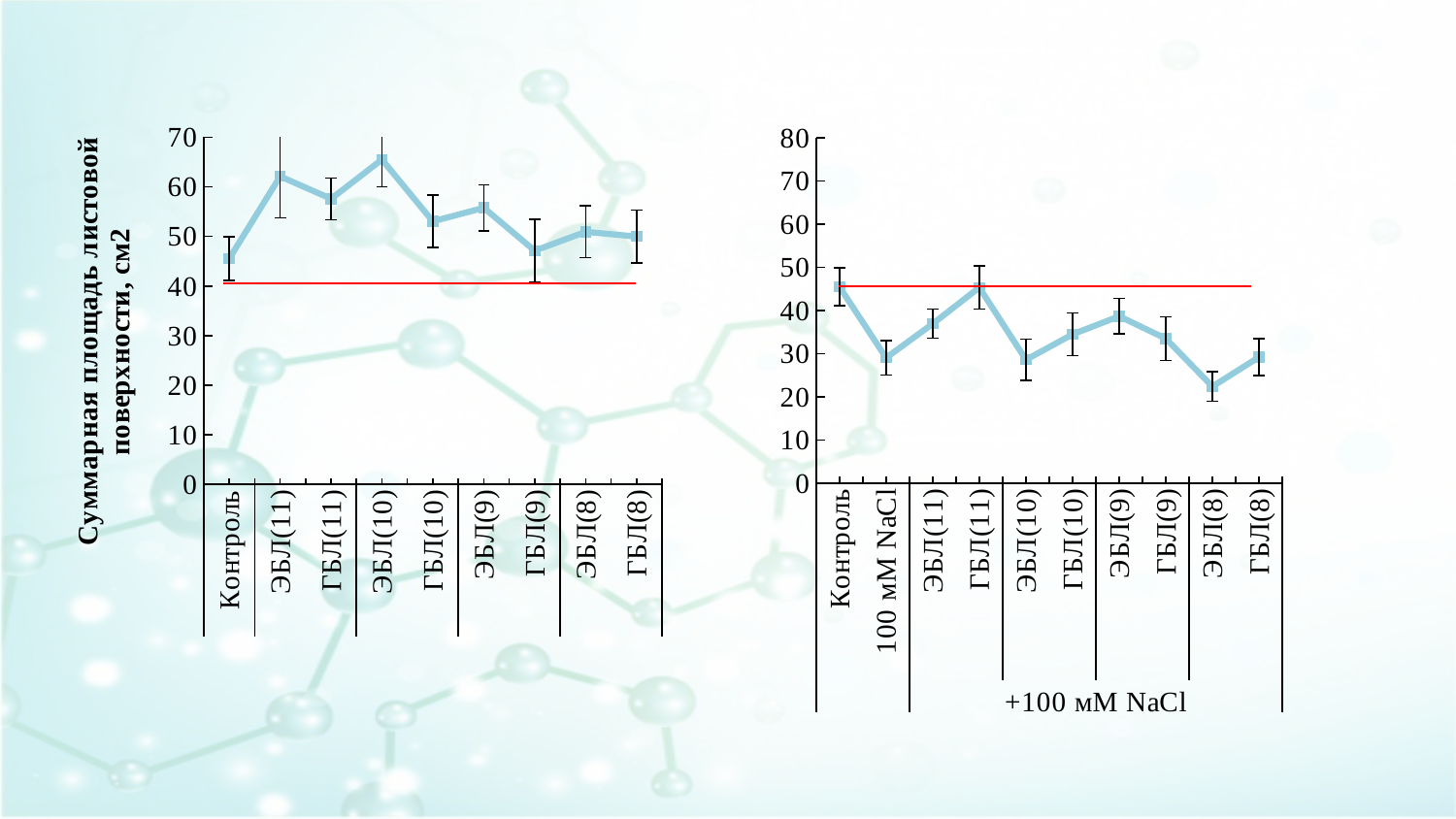
In the left chart, which is larger, the value for ЭБЛ(11) or the value for ГБЛ(11)? ЭБЛ(11) In the right chart, is the value for 100 мМ NaCl greater or less than 40? less In the left chart, which category has the highest value? ЭБЛ(10) What is the y-axis label shown on the slide? Суммарная площадь листовой поверхности, см2 What kind of chart is the left chart on the slide? line chart In the left chart, is the value for Контроль greater or less than 50? less In the right chart, is the value for ЭБЛ(8) greater or less than 30? less In the right chart, which is larger, the value for ЭБЛ(11) or the value for ЭБЛ(10)? ЭБЛ(11) How many categories are plotted on the x axis of the left chart? 9 In the right chart, which category has the lowest value? ЭБЛ(8) How many categories are plotted on the x axis of the right chart? 10